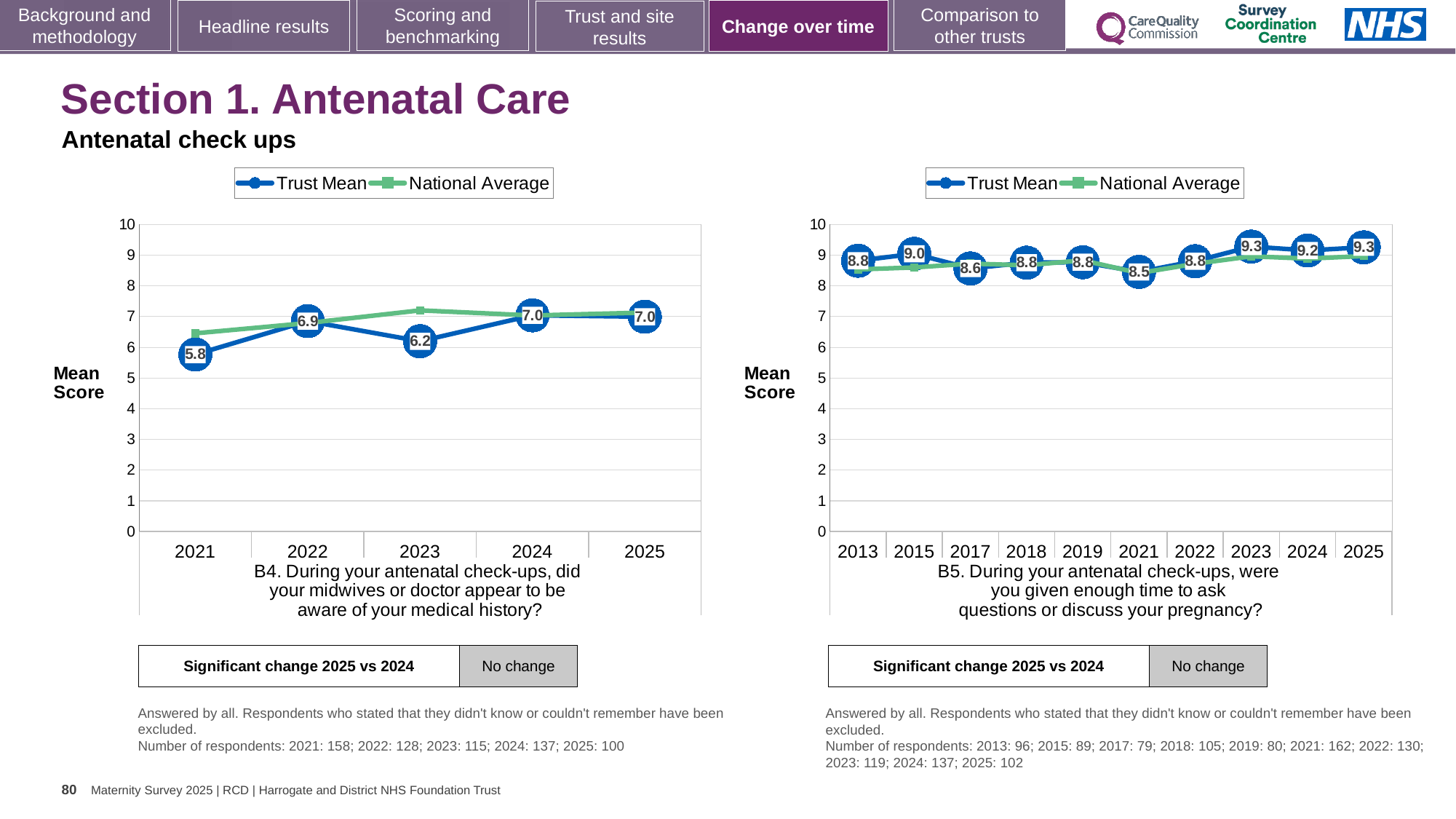
How many years are plotted on the B5 chart (right)? 10 On the B4 chart (left), what is the difference between the Trust Mean in 2025 and in 2021? 1.2 On the B5 chart (right), what is the Trust Mean for 2017? 8.6 What type of chart is the B5 chart (right)? Line chart On the B4 chart (left), is the Trust Mean higher in 2022 or in 2023? 2022 On the B5 chart (right), which year has the lowest Trust Mean? 2021 On the B5 chart (right), what is the difference between the Trust Mean in 2023 and in 2021? 0.8 On the B4 chart (left), what is the Trust Mean for 2023? 6.2 On the B4 chart (left), what is the Trust Mean for 2021? 5.8 On the B4 chart (left), is the National Average for 2021 greater or less than 7? less On the B4 chart (left), which year has the lowest Trust Mean? 2021 How many series does the legend of the B4 chart (left) list? 2